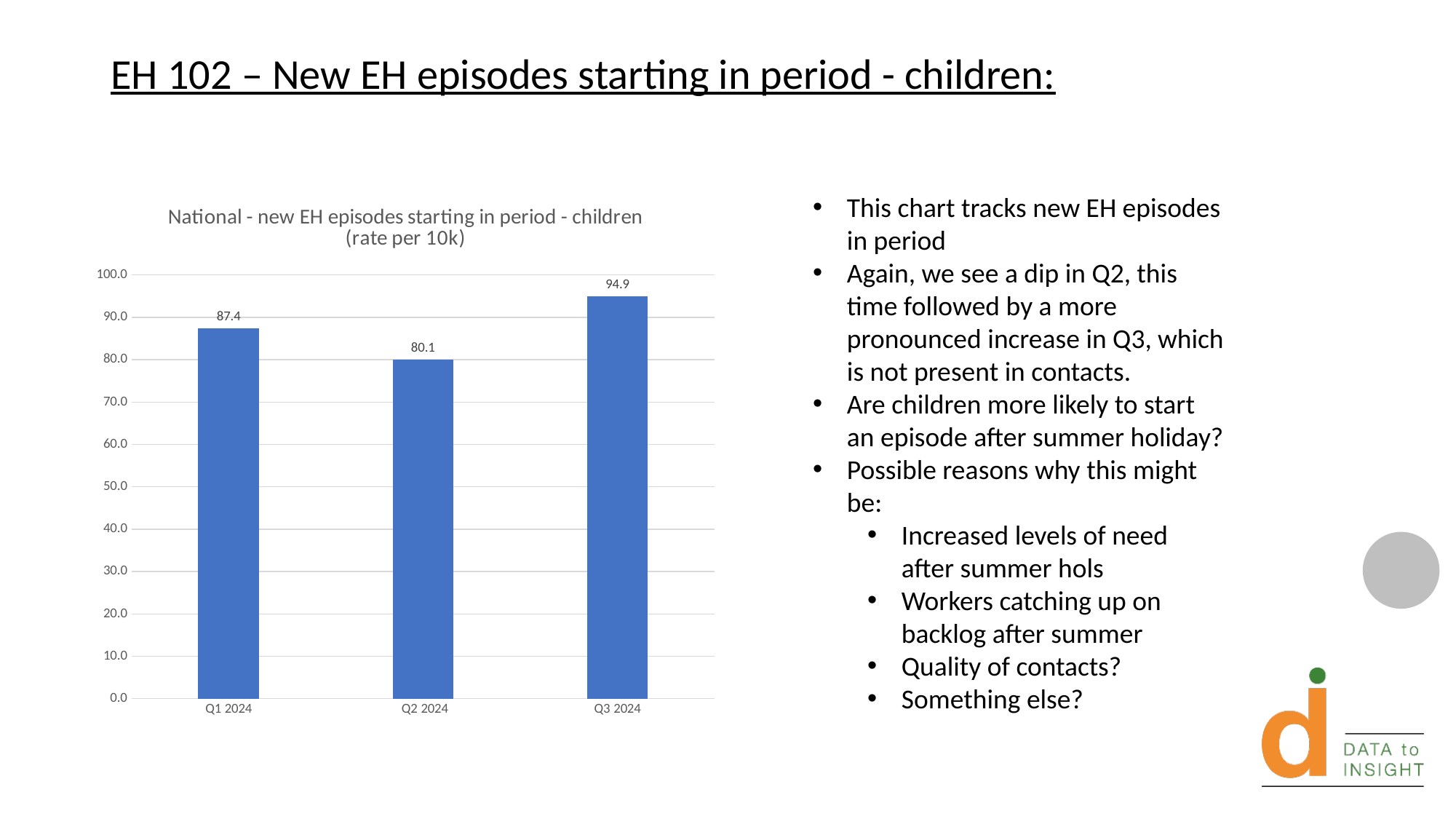
What is the value for Q1 2024? 87.4 How many quarters are shown on the chart? 3 Is the value for Q2 2024 greater or less than 90.0? less What is the difference between the values for Q1 2024 and Q2 2024? 7.3 Which quarter has the highest value? Q3 2024 Which is larger, the value for Q1 2024 or Q3 2024? Q3 2024 What kind of chart is shown on the slide? bar chart What is the title of the chart? National - new EH episodes starting in period - children (rate per 10k) Which quarter has the lowest value? Q2 2024 What is the value for Q2 2024? 80.1 What is the value for Q3 2024? 94.9 What is the difference between the values for Q3 2024 and Q2 2024? 14.8